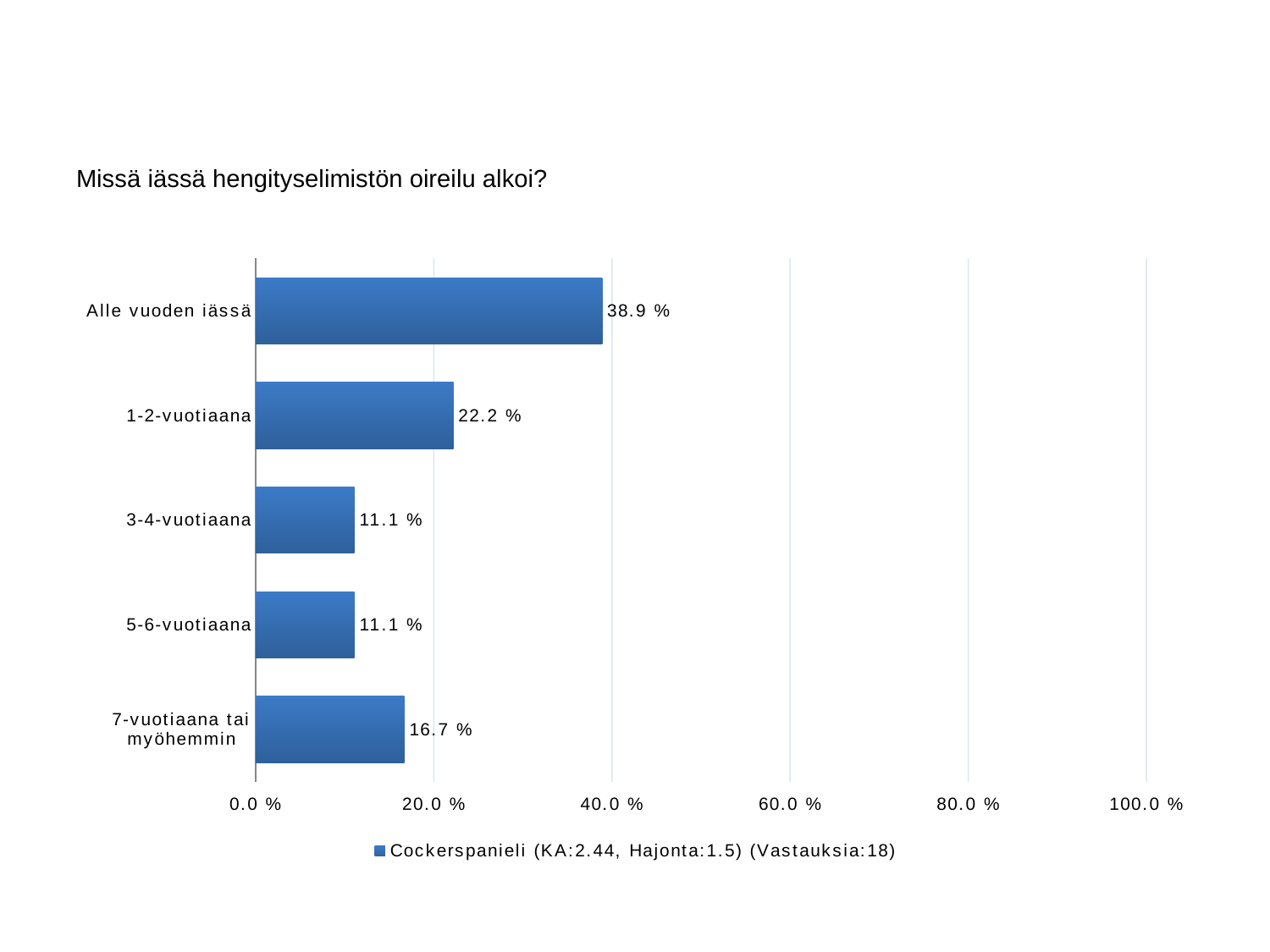
What is the title of the chart? Missä iässä hengityselimistön oireilu alkoi? Which category has the highest value? Alle vuoden iässä What is the value for "7-vuotiaana tai myöhemmin"? 16.7 % What is the value for "Alle vuoden iässä"? 38.9 % What kind of chart is shown on the slide? bar chart How many categories are shown in the chart? 5 What is the difference between the values for "Alle vuoden iässä" and "1-2-vuotiaana"? 16.7 % Is the value for "Alle vuoden iässä" greater or less than 20.0 %? greater What is the value for "1-2-vuotiaana"? 22.2 % How many responses (Vastauksia) does the legend entry report? 18 How many series does the legend list? 1 Which is larger, the value for "1-2-vuotiaana" or the value for "7-vuotiaana tai myöhemmin"? 1-2-vuotiaana